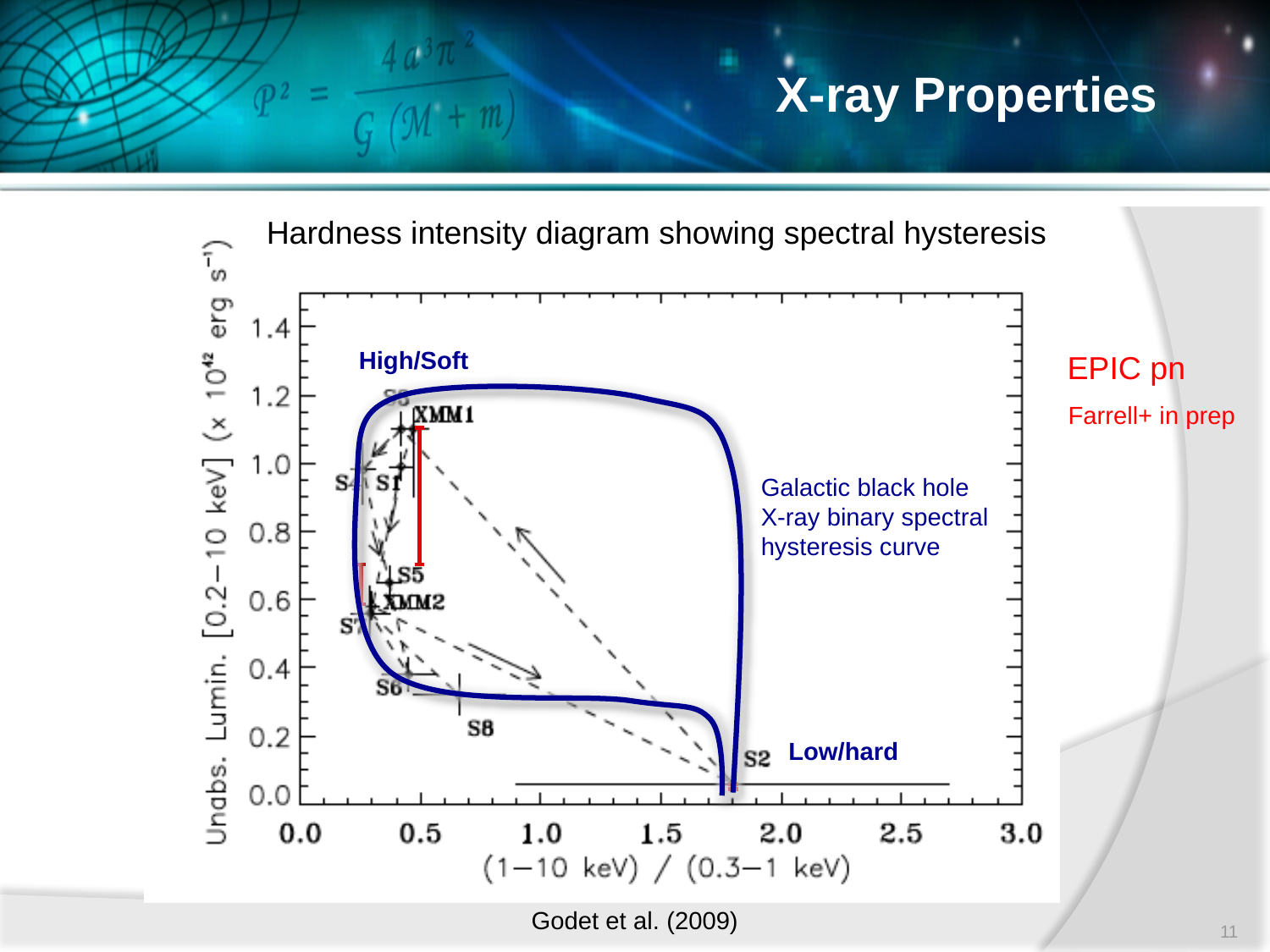
What kind of chart is shown on the slide? Scatter plot Which has the higher hardness ratio, S8 or S6? S8 Which labelled point has the highest hardness ratio (1-10 keV)/(0.3-1 keV)? S2 Is the hardness ratio for S2 greater or less than 1.5? greater Which labelled point has the lowest unabsorbed luminosity? S2 Is the unabsorbed luminosity for S8 greater or less than 0.5? less What does the blue curve on the chart represent, according to the annotation? Galactic black hole X-ray binary spectral hysteresis curve Is the hardness ratio for XMM1 greater or less than 1.0? less What is the label on the x axis of the chart? (1-10 keV) / (0.3-1 keV) Which has the higher unabsorbed luminosity, XMM1 or XMM2? XMM1